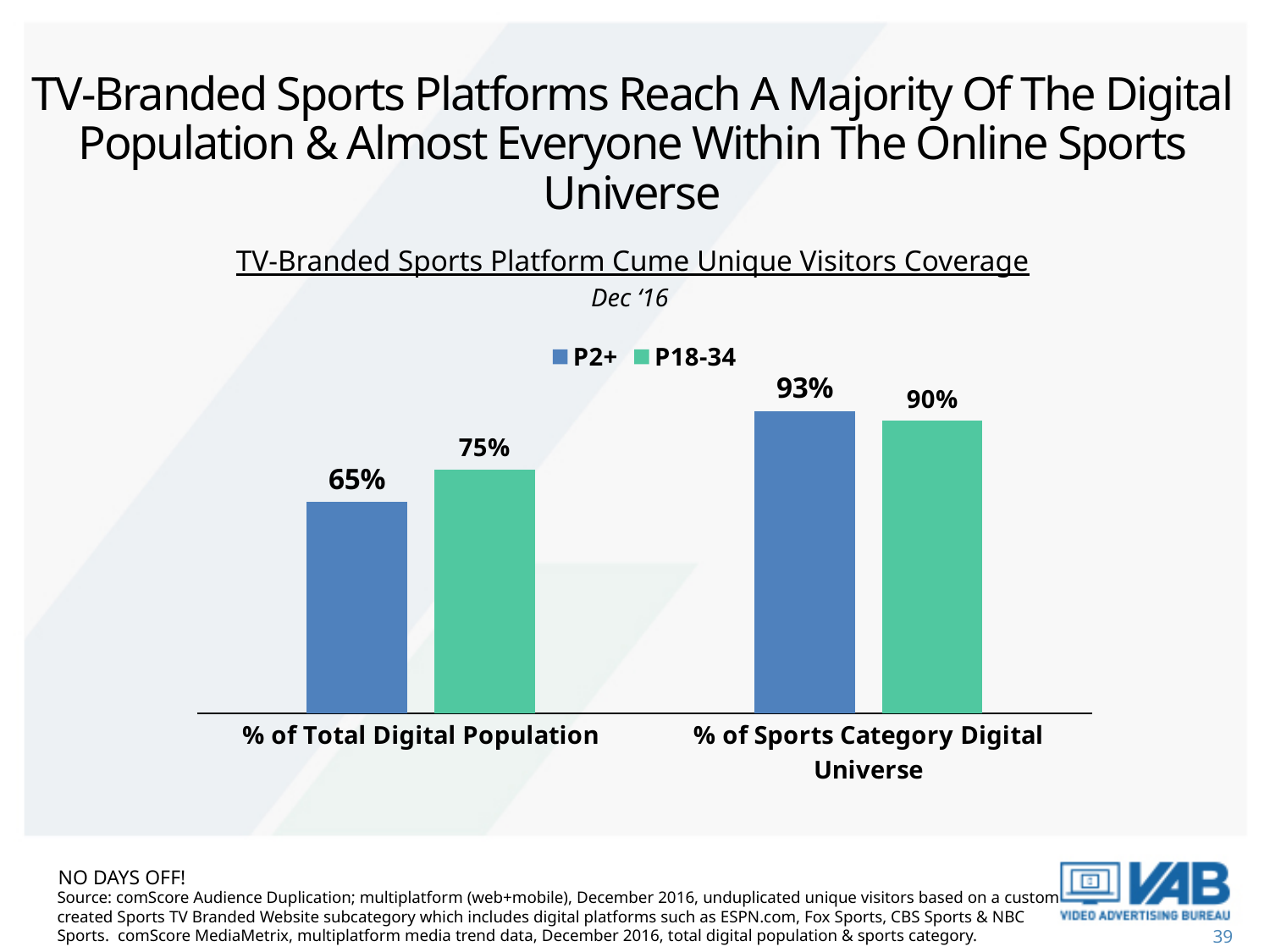
What is the difference between the P2+ and P18-34 values for % of Sports Category Digital Universe? 3% Which category has the highest P2+ value? % of Sports Category Digital Universe What kind of chart is shown on the slide? Bar chart What is the P18-34 value for % of Sports Category Digital Universe? 90% How many series does the legend list? 2 For % of Total Digital Population, which series has the larger value, P2+ or P18-34? P18-34 How many categories are shown on the x axis? 2 What is the P2+ value for % of Sports Category Digital Universe? 93% What is the P2+ value for % of Total Digital Population? 65% What is the difference between the P18-34 and P2+ values for % of Total Digital Population? 10% Which category has the lowest P18-34 value? % of Total Digital Population What is the P18-34 value for % of Total Digital Population? 75%